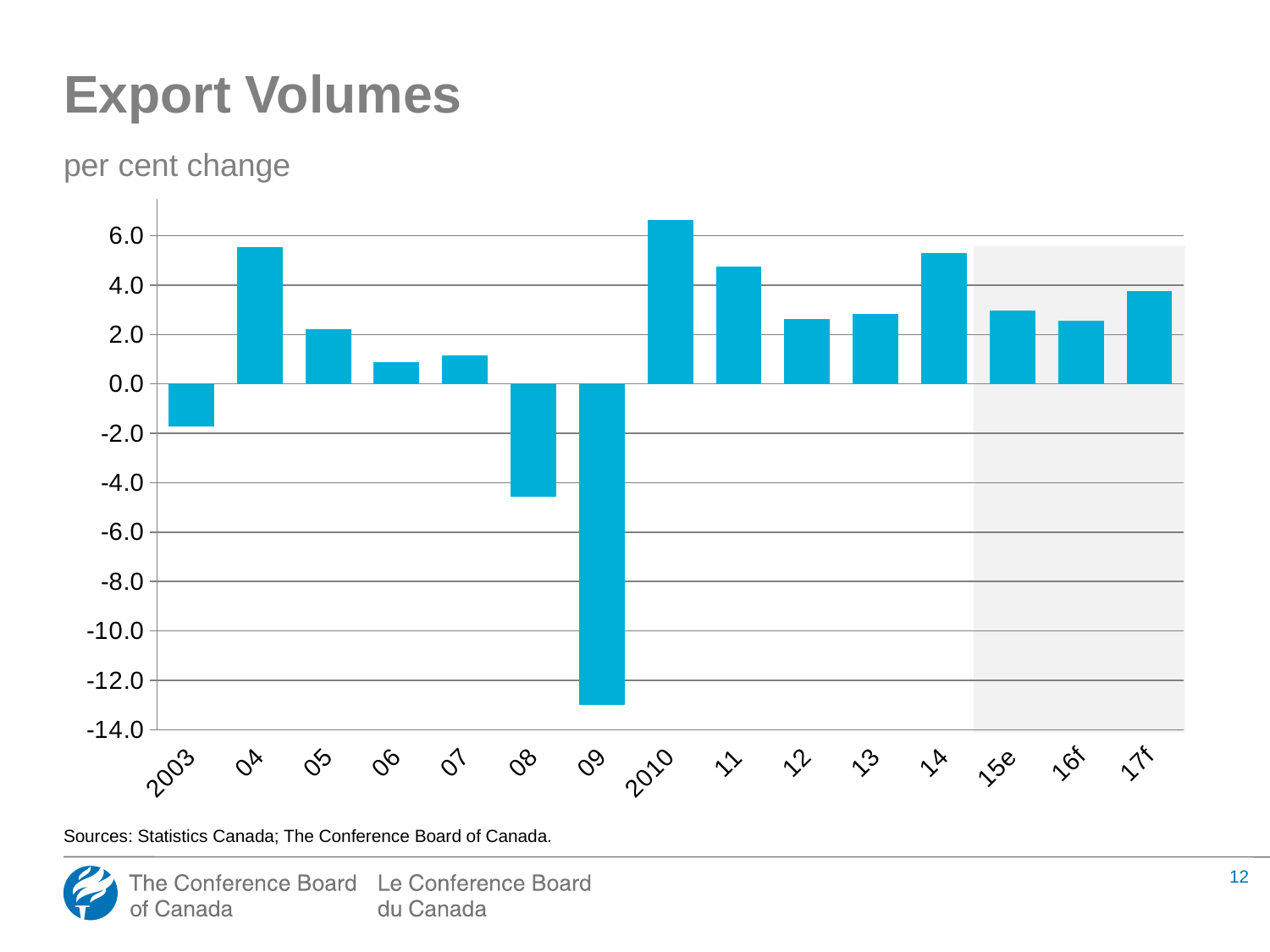
What is the title of the chart? Export Volumes Is the value for 08 greater or less than -4.0? less Is the value for 17f greater or less than 4.0? less What kind of chart is shown on the slide? bar chart Which is larger, the value for 2010 or the value for 04? 2010 Which year has the highest export volume growth? 2010 Which year has the lowest export volume change? 09 Which is lower, the value for 08 or the value for 2003? 08 Is the value for 2010 greater or less than 6.0? greater How many years (categories) are plotted on the x axis? 15